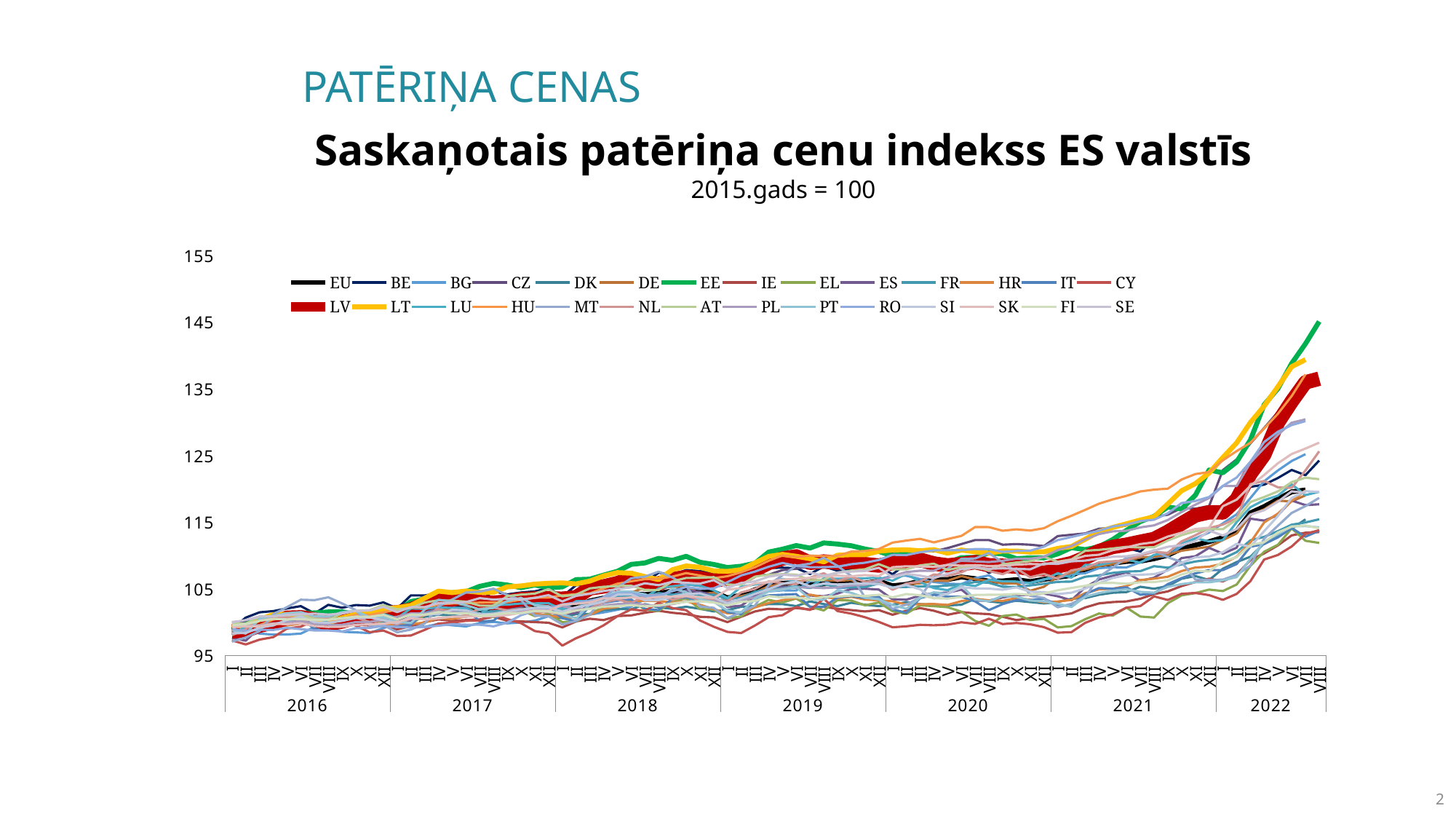
What kind of chart is shown on the slide? line chart At the end of the chart, which is larger: the value for LT or the value for EU? LT At the end of the chart, which is larger: the value for EE or the value for LV? EE How many series does the legend list? 28 Is the value for EE at the end of 2022 greater or less than 135? greater How many years are labelled along the x axis? 7 What is the title of the chart? Saskaņotais patēriņa cenu indekss ES valstīs Is the value for LV at the end of the chart greater or less than 125? greater Is the value for EU at the end of the chart greater or less than 125? less Which series has the highest value at the end of the chart (2022)? EE Do the index values generally rise or fall from 2016 to 2022? rise What base year is the index set to 100, according to the subtitle? 2015